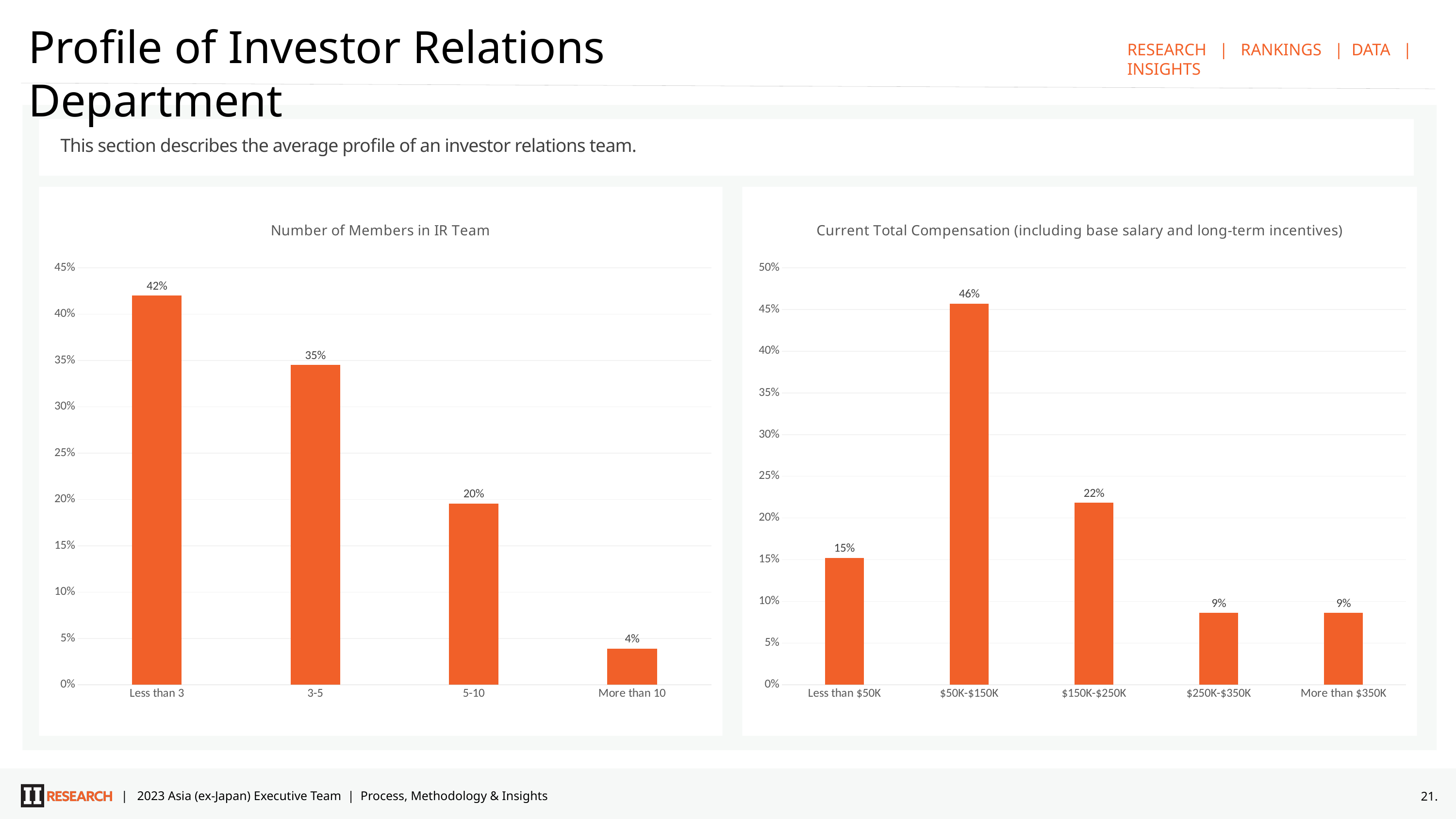
In the 'Current Total Compensation' chart, which is larger: the value for 'Less than $50K' or the value for '$150K-$250K'? $150K-$250K In the 'Number of Members in IR Team' chart, do the values rise or fall from left to right along the x axis? fall In the 'Current Total Compensation' chart, which category has the highest value? $50K-$150K In the 'Current Total Compensation' chart, what is the value for '$150K-$250K'? 22% In the 'Number of Members in IR Team' chart, what is the value for 'Less than 3'? 42% In the 'Current Total Compensation' chart, how many categories are shown on the x axis? 5 In the 'Number of Members in IR Team' chart, which category has the lowest value? More than 10 In the 'Number of Members in IR Team' chart, what is the difference between the values for 'Less than 3' and '3-5'? 7% What kind of chart is the 'Current Total Compensation' chart? bar chart In the 'Number of Members in IR Team' chart, how many categories are shown on the x axis? 4 In the 'Current Total Compensation' chart, what is the difference between the values for '$50K-$150K' and 'Less than $50K'? 31% In the 'Number of Members in IR Team' chart, what is the value for '5-10'? 20%